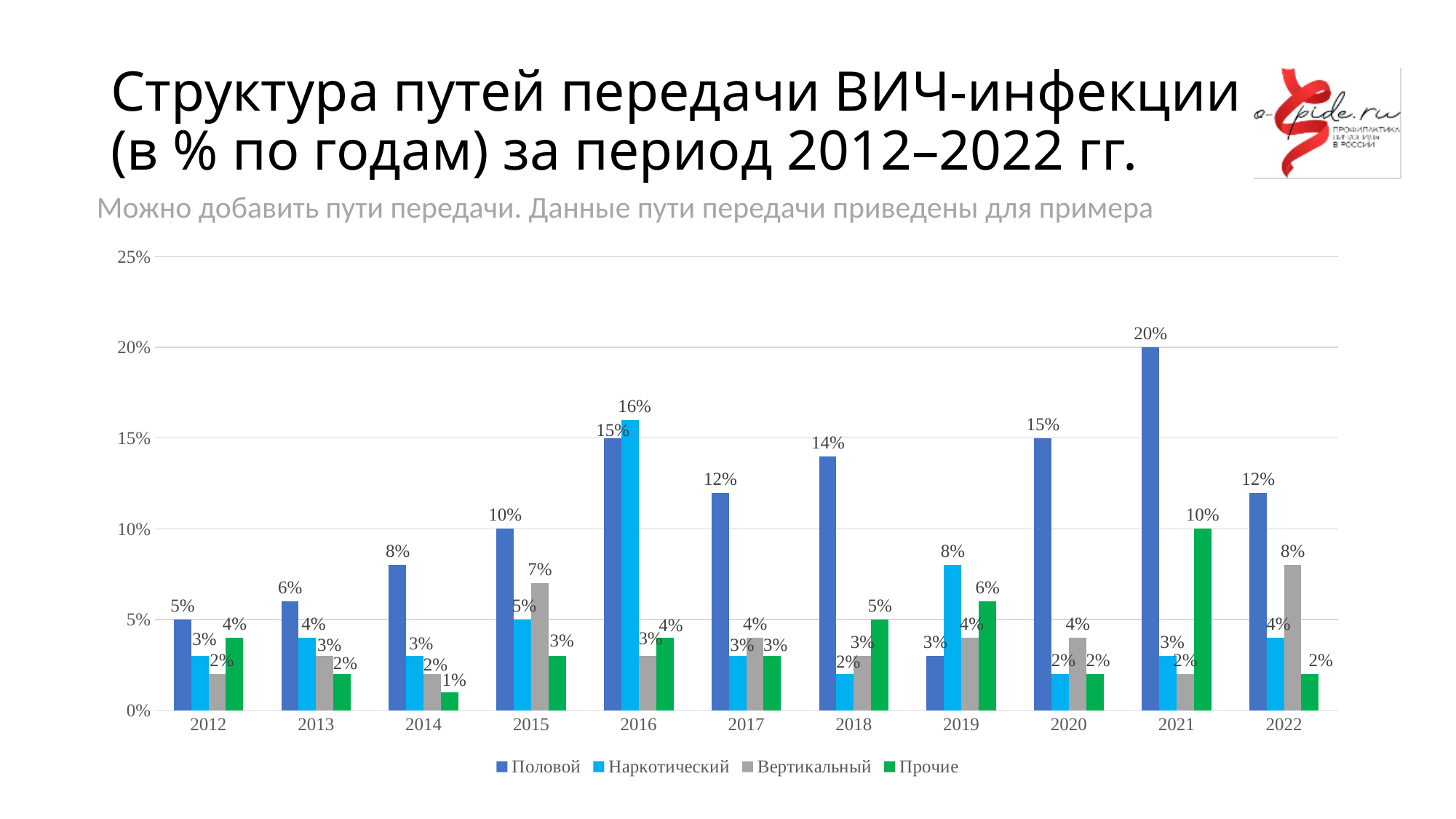
What is the difference between Половой and Прочие in 2021? 10% Which series is shown in green in the legend? Прочие What is the value for Вертикальный in 2022? 8% What is the value for Половой in 2021? 20% What is the value for Прочие in 2014? 1% In which year is the Половой series highest? 2021 What is the value for Наркотический in 2016? 16% Which is larger in 2019: Половой or Наркотический? Наркотический In which year is the Прочие series lowest? 2014 What kind of chart is shown on the slide? Bar chart How many series does the legend list? 4 How many years are shown on the x axis? 11